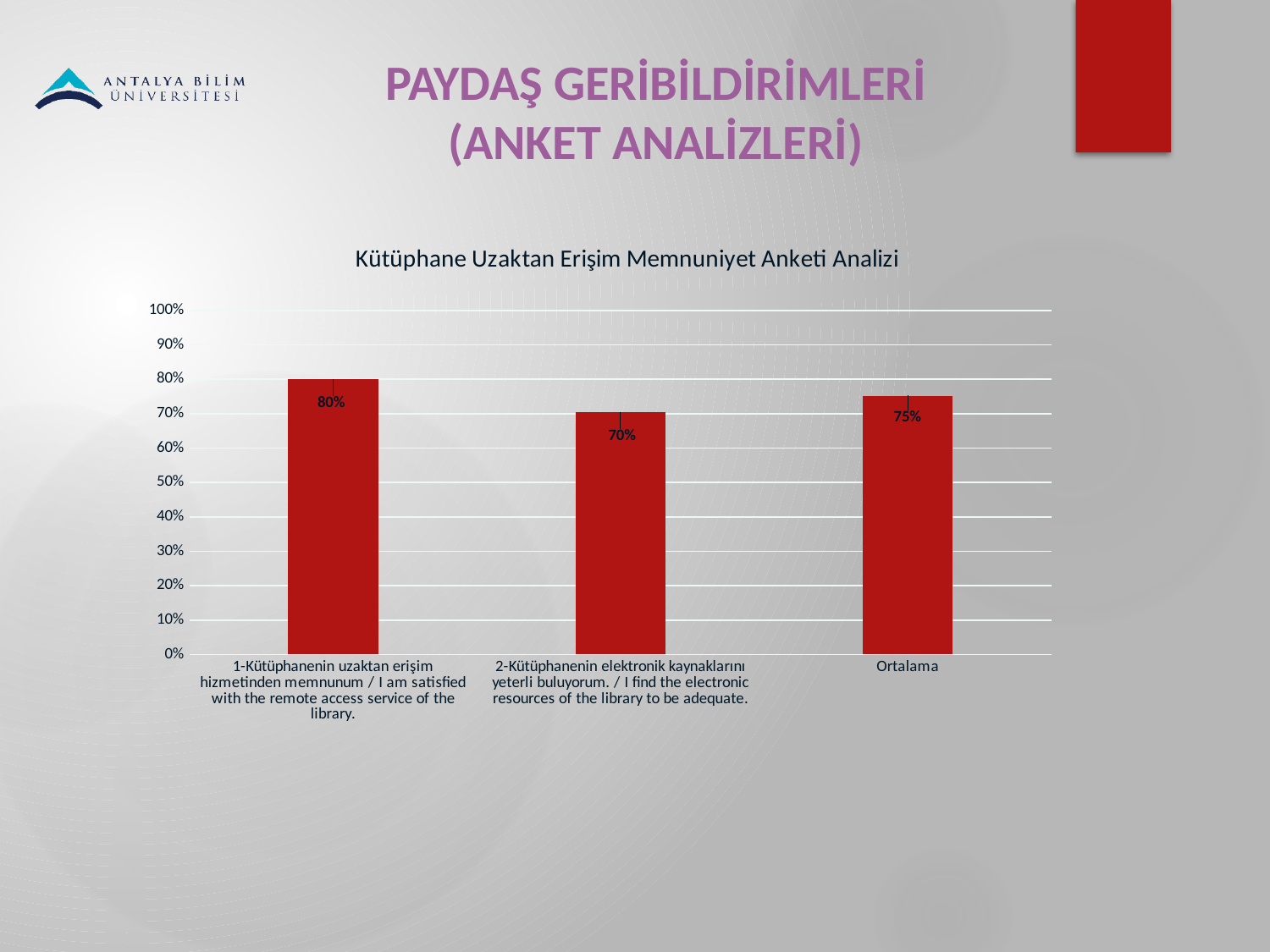
What kind of chart is shown on the slide? bar chart How many categories are shown in the chart? 3 What is the value for the first category, '1-Kütüphanenin uzaktan erişim hizmetinden memnunum / I am satisfied with the remote access service of the library.'? 80% Is the value for 'Ortalama' greater or less than 50%? greater What is the value for '2-Kütüphanenin elektronik kaynaklarını yeterli buluyorum. / I find the electronic resources of the library to be adequate.'? 70% What is the difference between the value for the first category (remote access service) and the second category (electronic resources)? 10% Which is larger: the value for 'Ortalama' or the value for the second category (electronic resources)? Ortalama Which category has the highest value? 1-Kütüphanenin uzaktan erişim hizmetinden memnunum / I am satisfied with the remote access service of the library. What is the title of the chart? Kütüphane Uzaktan Erişim Memnuniyet Anketi Analizi Which category has the lowest value? 2-Kütüphanenin elektronik kaynaklarını yeterli buluyorum. / I find the electronic resources of the library to be adequate. What colour are the bars in the chart? red What is the value for 'Ortalama'? 75%